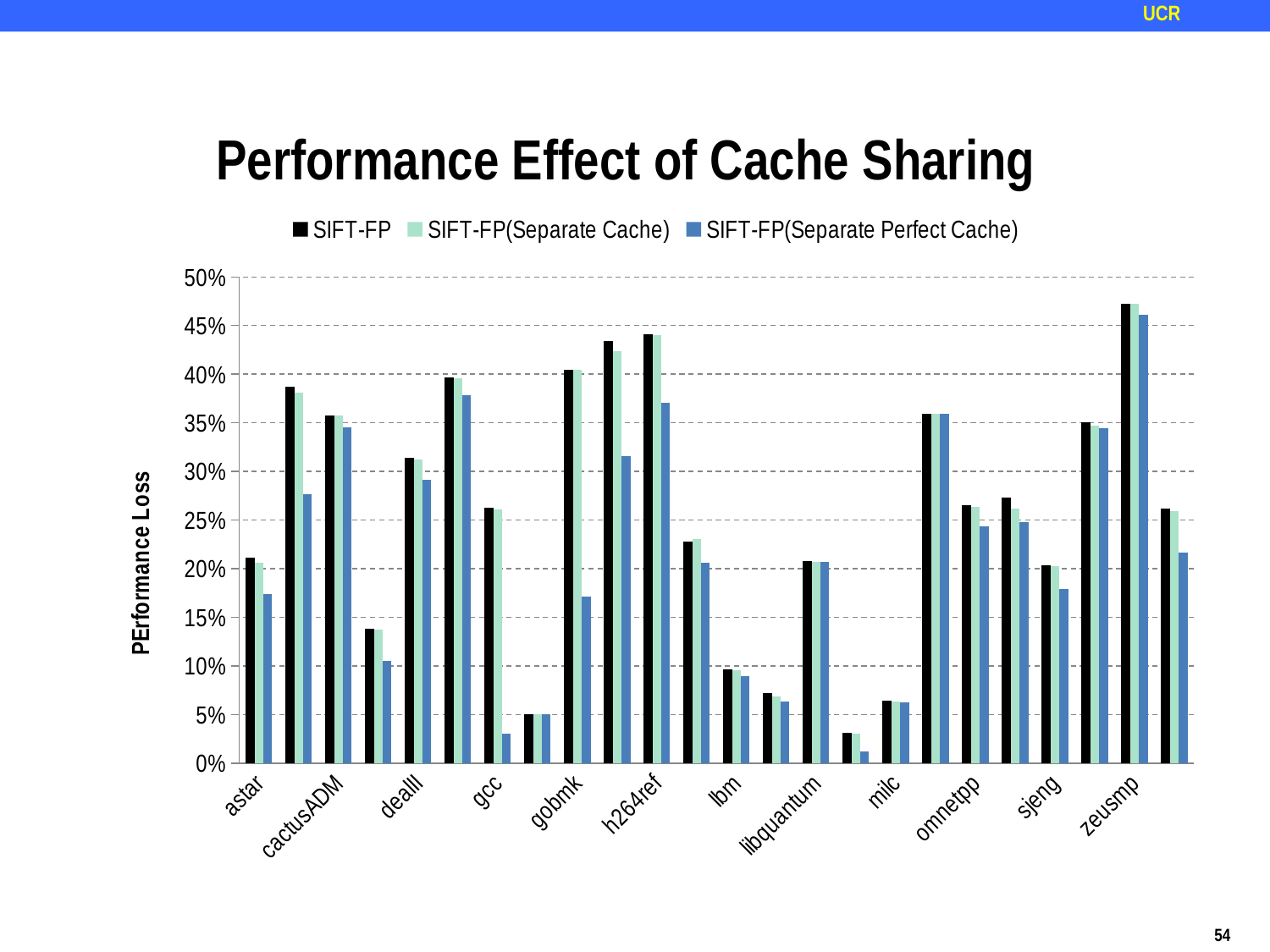
Is the SIFT-FP(Separate Perfect Cache) value for gobmk greater or less than 20%? less For gobmk, which is larger: the SIFT-FP bar or the SIFT-FP(Separate Perfect Cache) bar? SIFT-FP Is the SIFT-FP value for zeusmp greater or less than 45%? greater What is the title of the chart? Performance Effect of Cache Sharing Is the SIFT-FP(Separate Perfect Cache) value for gcc greater or less than 5%? less What are the three series named in the legend? SIFT-FP, SIFT-FP(Separate Cache), SIFT-FP(Separate Perfect Cache) How many series does the legend list? 3 What kind of chart is shown on the slide? bar chart Which labeled benchmark has the highest SIFT-FP performance loss? zeusmp